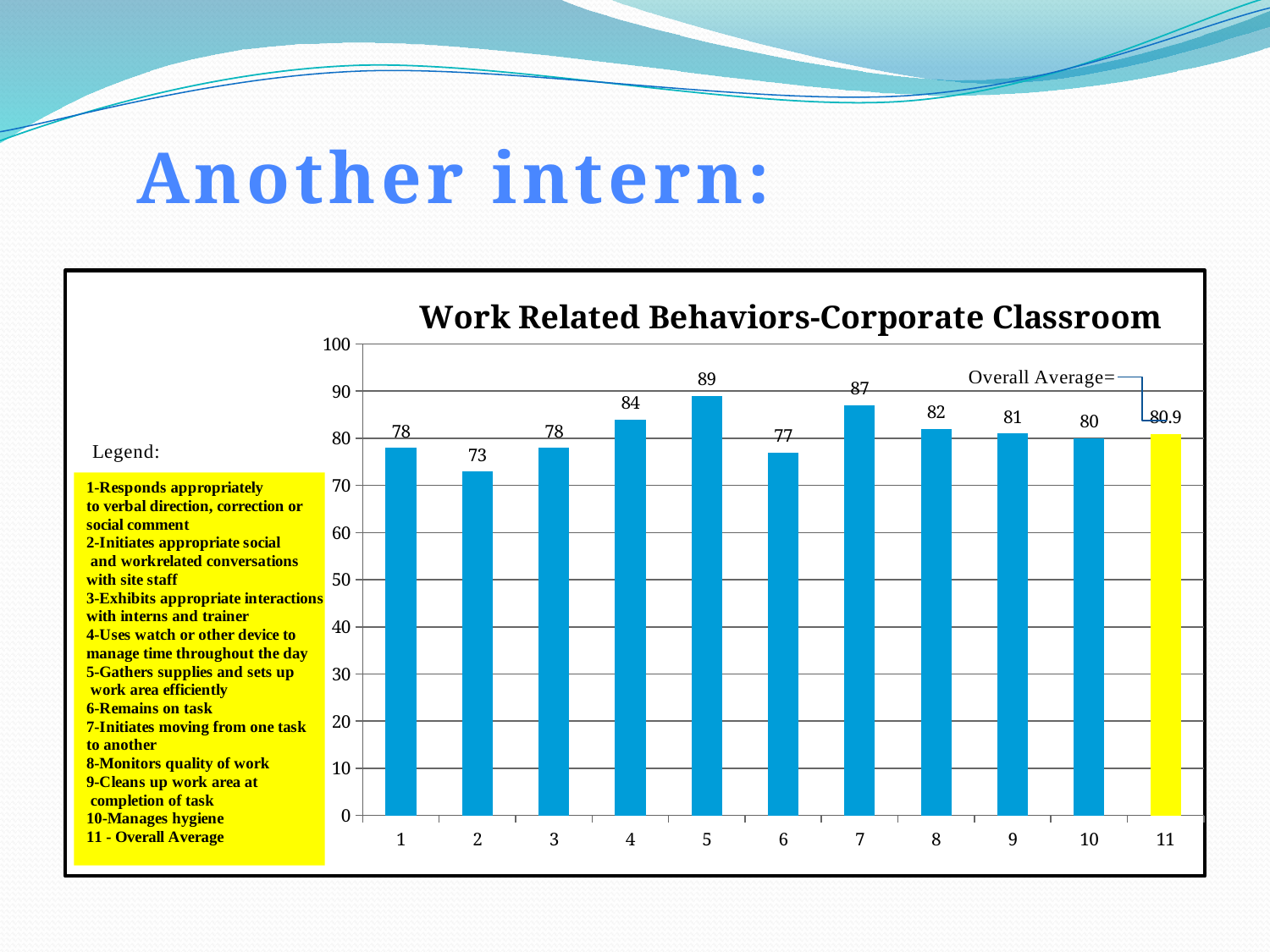
Which category has the lowest value in the chart? 2 What colour is the bar for category 11 in the chart? yellow What is the value for category 2 in the chart? 73 What kind of chart is shown on the slide? bar chart Which is larger, the value for category 4 or the value for category 7? 7 Is the value for category 6 greater or less than 80? less Which category has the highest value in the chart? 5 How many bars are plotted in the chart? 11 What is the difference between the values for category 5 and category 2? 16 What is the title of the chart? Work Related Behaviors-Corporate Classroom What is the value shown for category 11 (Overall Average) in the chart? 80.9 What is the value for category 5 in the Work Related Behaviors-Corporate Classroom chart? 89